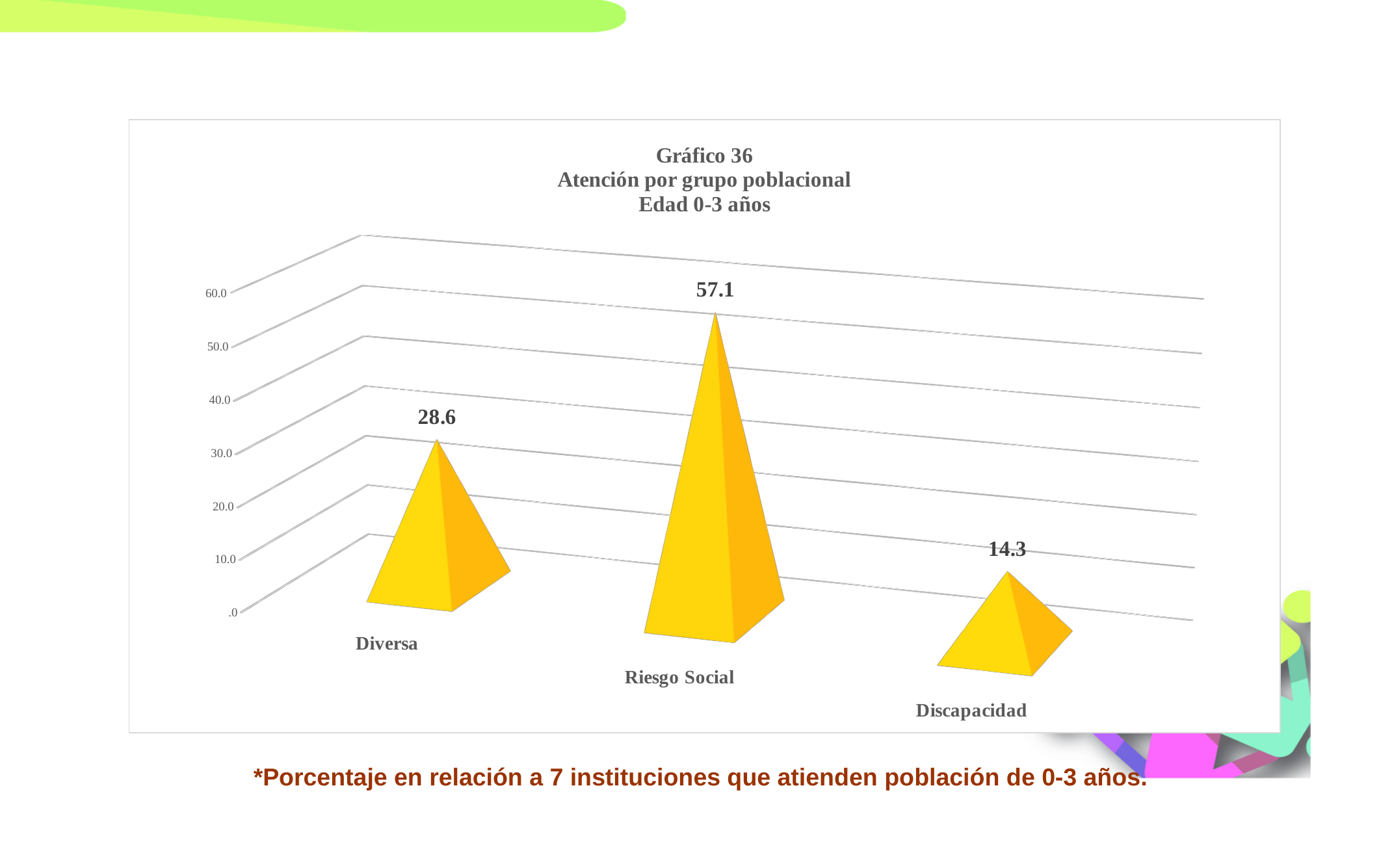
Which is larger, the value for Diversa or the value for Discapacidad? Diversa What is the value for Diversa? 28.6 What kind of chart is shown on the slide? bar chart Which category has the lowest value? Discapacidad What is the value for Riesgo Social? 57.1 What is the difference between the values for Diversa and Discapacidad? 14.3 How many categories are shown in the chart? 3 What is the title of the chart? Gráfico 36 Atención por grupo poblacional Edad 0-3 años What is the value for Discapacidad? 14.3 What is the difference between the values for Riesgo Social and Diversa? 28.5 Is the value for Riesgo Social greater or less than 50.0? greater Which category has the highest value? Riesgo Social